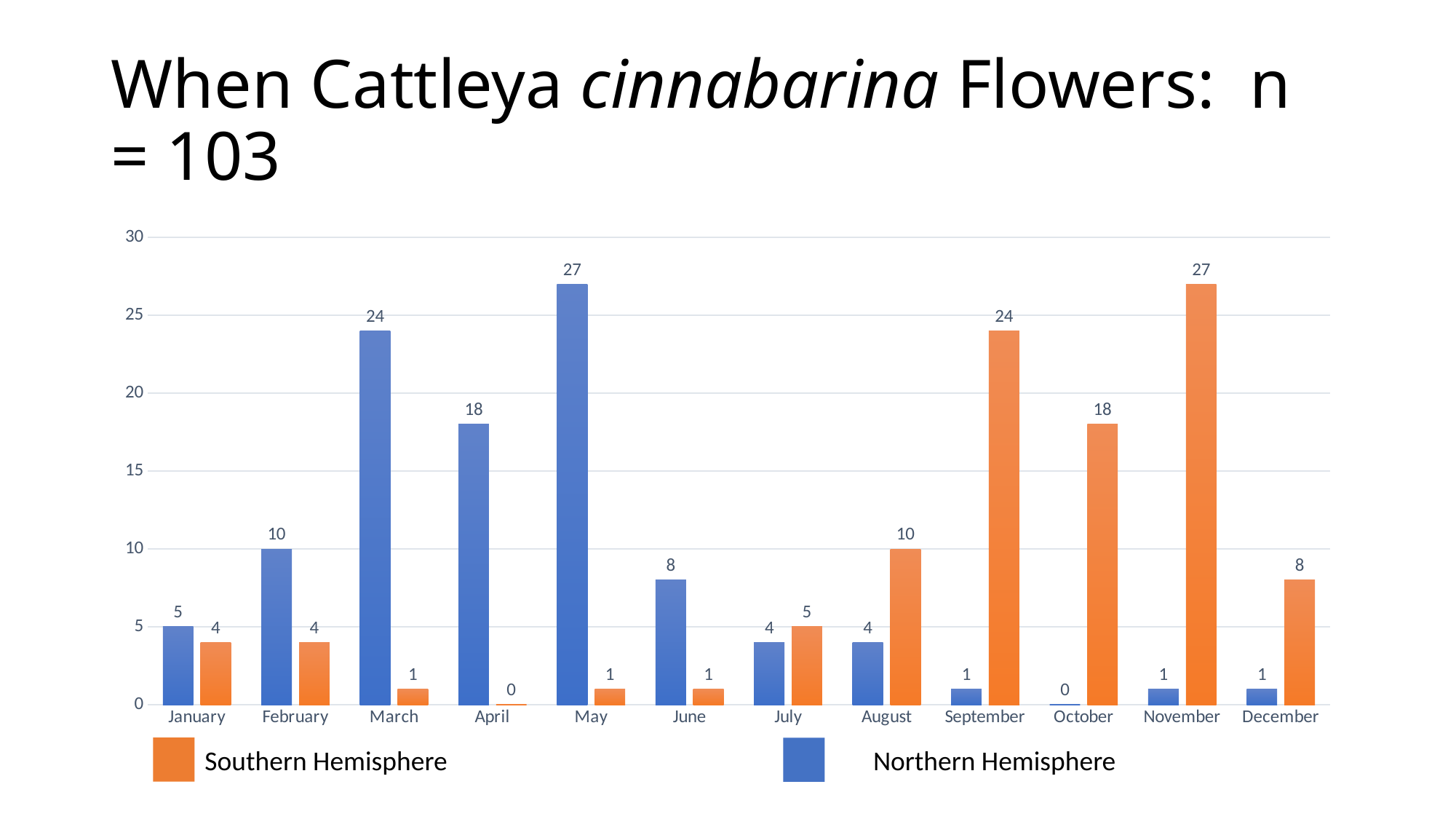
Is the Southern Hemisphere value for October greater or less than 15? greater What kind of chart is shown on the slide? Bar chart What is the difference between the Northern Hemisphere values for March and February? 14 What is the Northern Hemisphere value for October? 0 Which month has the highest Southern Hemisphere value? November How many months are shown on the x axis? 12 What is the Southern Hemisphere value for September? 24 Which is larger in July, the Southern Hemisphere value or the Northern Hemisphere value? Southern Hemisphere What is the Northern Hemisphere value for May? 27 Which month has the lowest Northern Hemisphere value? October How many series does the legend list? 2 Which colour represents the Southern Hemisphere series? Orange